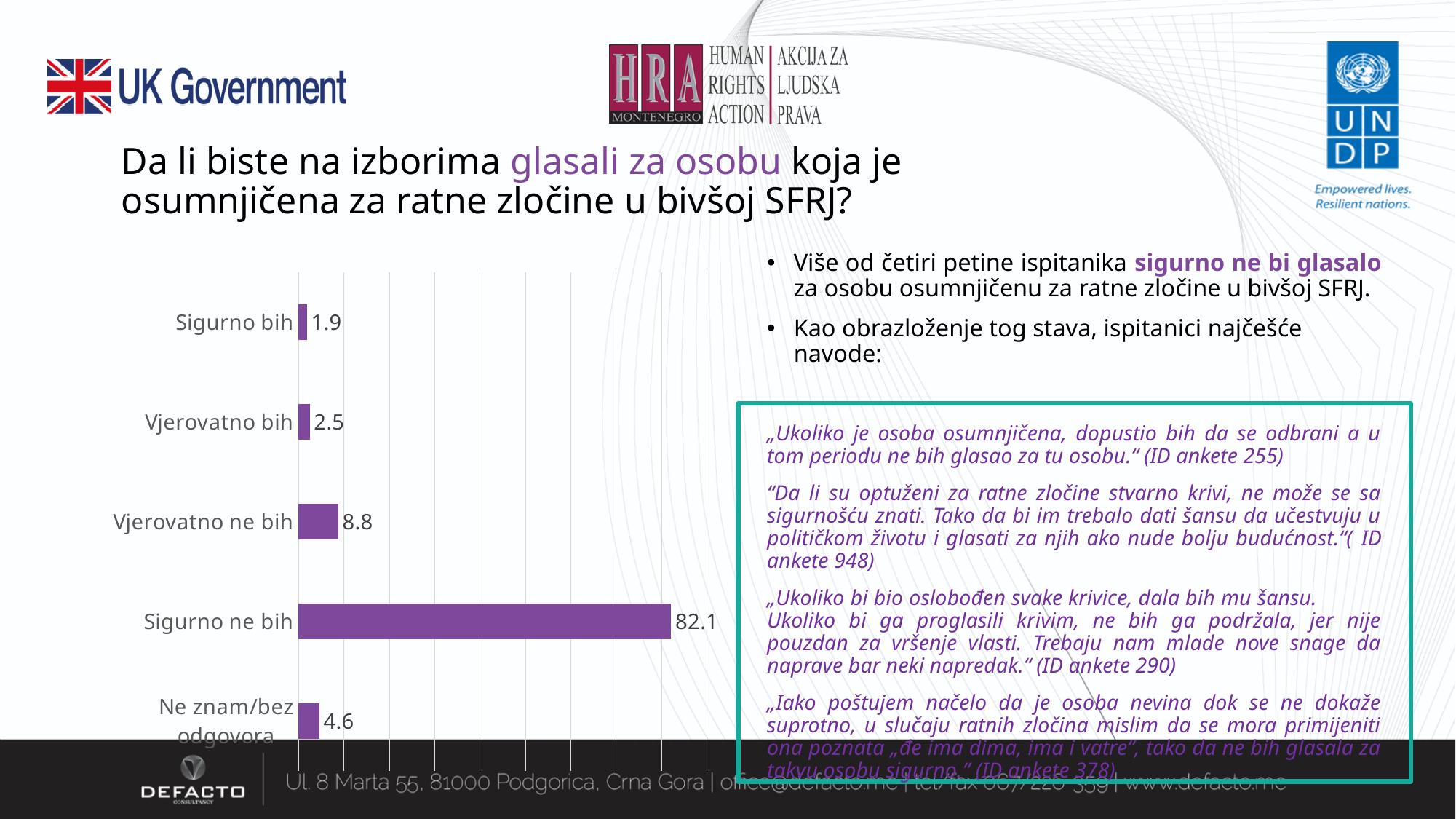
How many categories are shown in the chart? 5 What colour are the bars in the chart? Purple What value is shown for "Ne znam/bez odgovora"? 4.6 What kind of chart is shown on the slide? Bar chart What value is shown for "Vjerovatno ne bih"? 8.8 What is the difference between the values for "Sigurno ne bih" and "Vjerovatno ne bih"? 73.3 Which is larger, the value for "Ne znam/bez odgovora" or the value for "Vjerovatno bih"? Ne znam/bez odgovora What value is shown for "Sigurno ne bih"? 82.1 Which category has the highest value? Sigurno ne bih What value is shown for "Sigurno bih"? 1.9 Which category has the lowest value? Sigurno bih What value is shown for "Vjerovatno bih"? 2.5